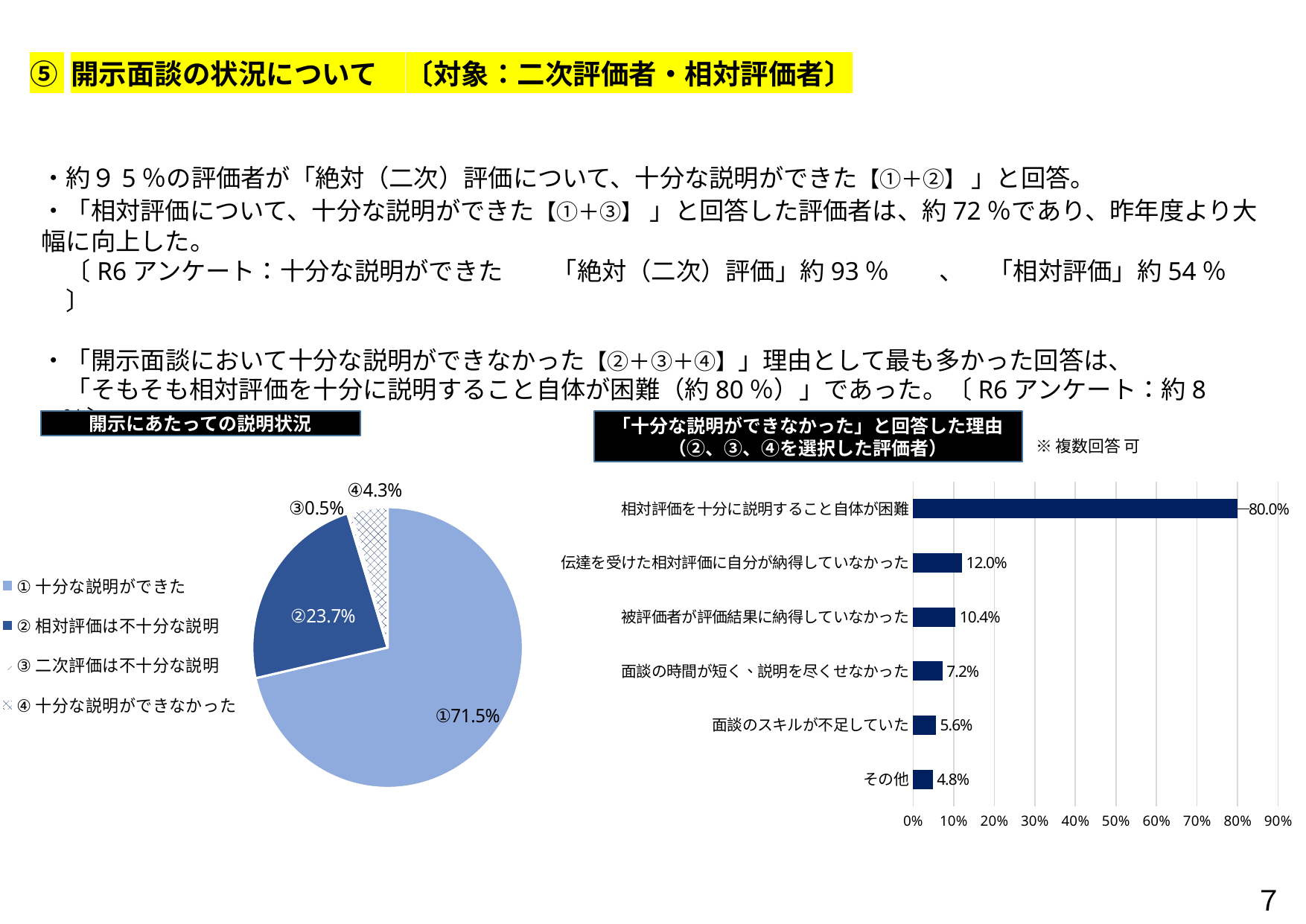
In the bar chart 「十分な説明ができなかった」と回答した理由, which is larger: 面談の時間が短く、説明を尽くせなかった or その他? 面談の時間が短く、説明を尽くせなかった In the pie chart 開示にあたっての説明状況, what share is labelled for ① 十分な説明ができた? 71.5% In the bar chart 「十分な説明ができなかった」と回答した理由, what is the difference between 伝達を受けた相対評価に自分が納得していなかった and 被評価者が評価結果に納得していなかった? 1.6% In the pie chart 開示にあたっての説明状況, what share is labelled for ② 相対評価は不十分な説明? 23.7% In the pie chart 開示にあたっての説明状況, how many categories does the legend list? 4 In the pie chart 開示にあたっての説明状況, what is the combined share of ① and ②? 95.2% In the bar chart 「十分な説明ができなかった」と回答した理由, what is the value for 面談のスキルが不足していた? 5.6% In the pie chart 開示にあたっての説明状況, which category has the smallest slice? ③ 二次評価は不十分な説明 In the bar chart 「十分な説明ができなかった」と回答した理由, what is the value for 相対評価を十分に説明すること自体が困難? 80.0% What type of chart is the right-hand chart 「十分な説明ができなかった」と回答した理由? bar chart In the bar chart 「十分な説明ができなかった」と回答した理由, which reason has the lowest value? その他 In the bar chart 「十分な説明ができなかった」と回答した理由, how many reasons are plotted? 6